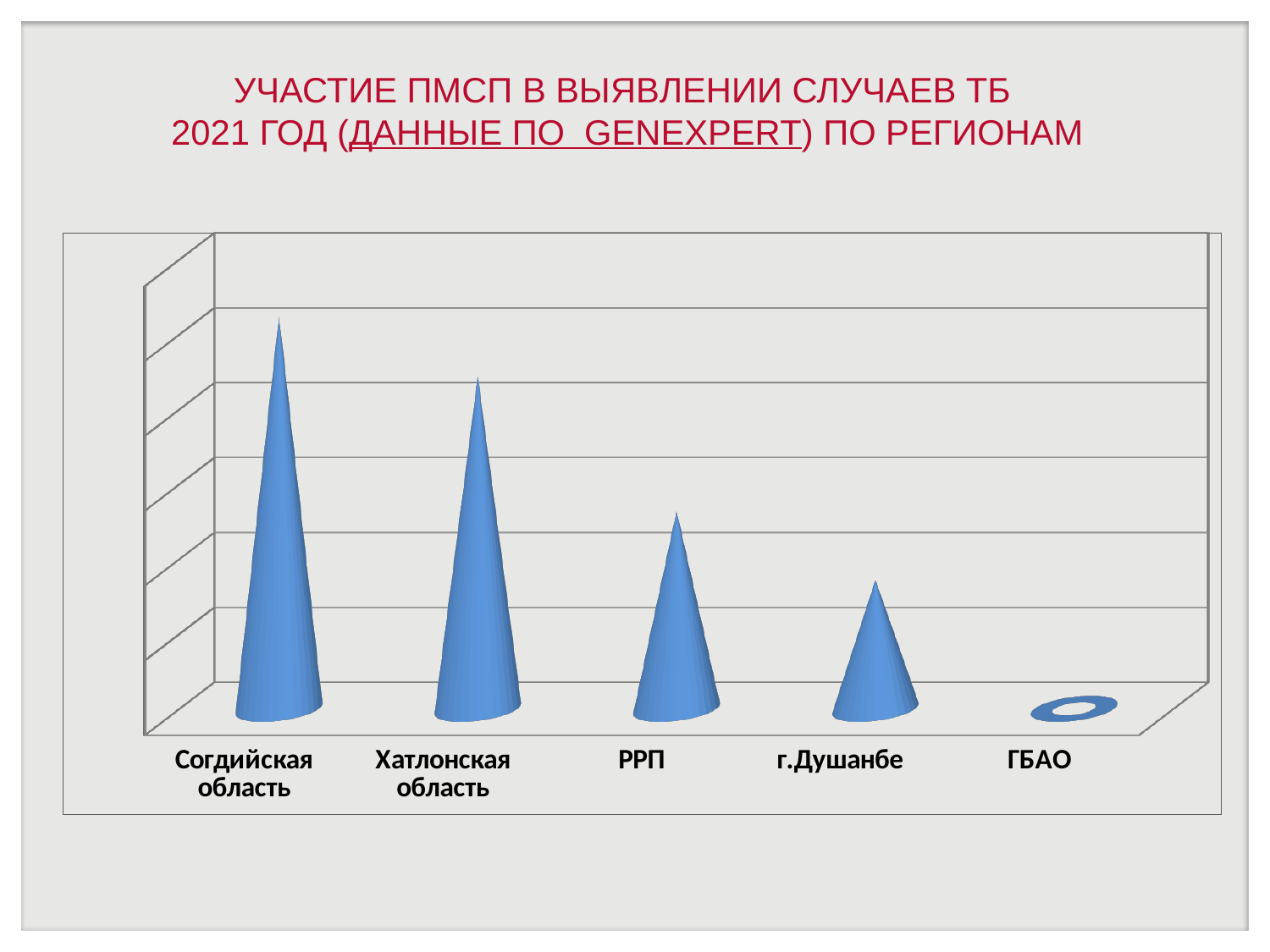
Which region is the second highest in the chart? Хатлонская область Do the values rise or fall from left to right across the regions? Fall Which has the larger value, г.Душанбе or ГБАО? г.Душанбе Which has the larger value, Согдийская область or Хатлонская область? Согдийская область Which region has the highest value in the chart? Согдийская область Which year does the slide title say the data refers to? 2021 What colour are the bars in the chart? Blue Which region has the lowest value in the chart? ГБАО What kind of chart is shown on the slide? Bar chart Which has the larger value, РРП or г.Душанбе? РРП How many regions are shown on the x axis of the chart? 5